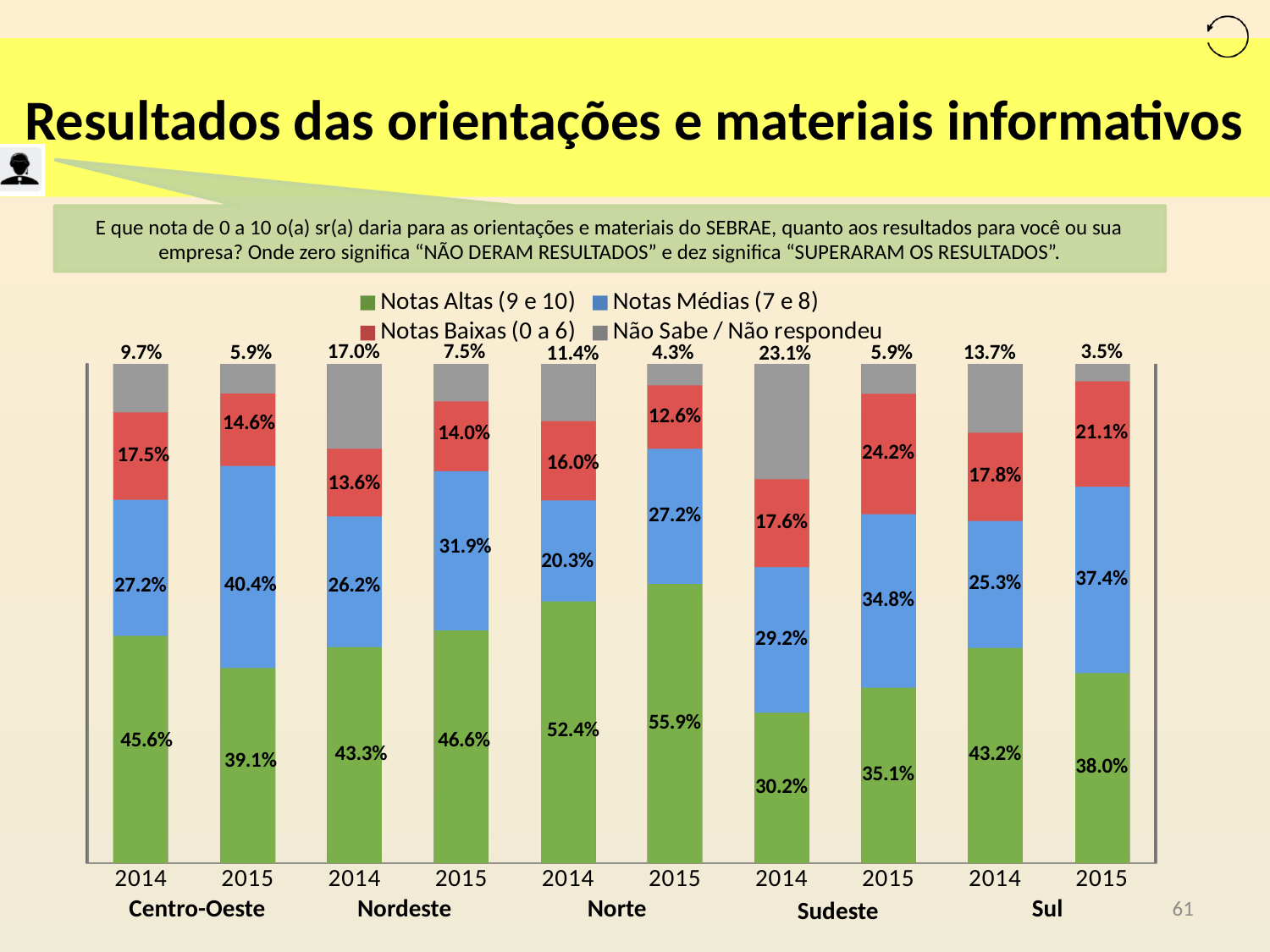
Which bar has the highest Notas Altas (9 e 10) share? Norte 2015 Did the Não Sabe / Não respondeu share in Sul rise or fall from 2014 to 2015? Fall What is the Não Sabe / Não respondeu share for Sudeste in 2014? 23.1% By how many percentage points did the Notas Altas share in Norte change from 2014 to 2015? 3.5 percentage points Which bar has the lowest Notas Altas (9 e 10) share? Sudeste 2014 What type of chart is shown on the slide? Stacked bar chart What is the combined share of Notas Altas (9 e 10) and Notas Médias (7 e 8) for Sul in 2015? 75.4% Which is larger: the Notas Baixas (0 a 6) share for Sudeste 2015 or for Sul 2015? Sudeste 2015 How many bars are plotted in the chart? 10 What is the Notas Médias (7 e 8) value for Centro-Oeste in 2015? 40.4% How many series does the legend list? 4 What percentage of respondents in Norte in 2015 gave Notas Altas (9 e 10)? 55.9%